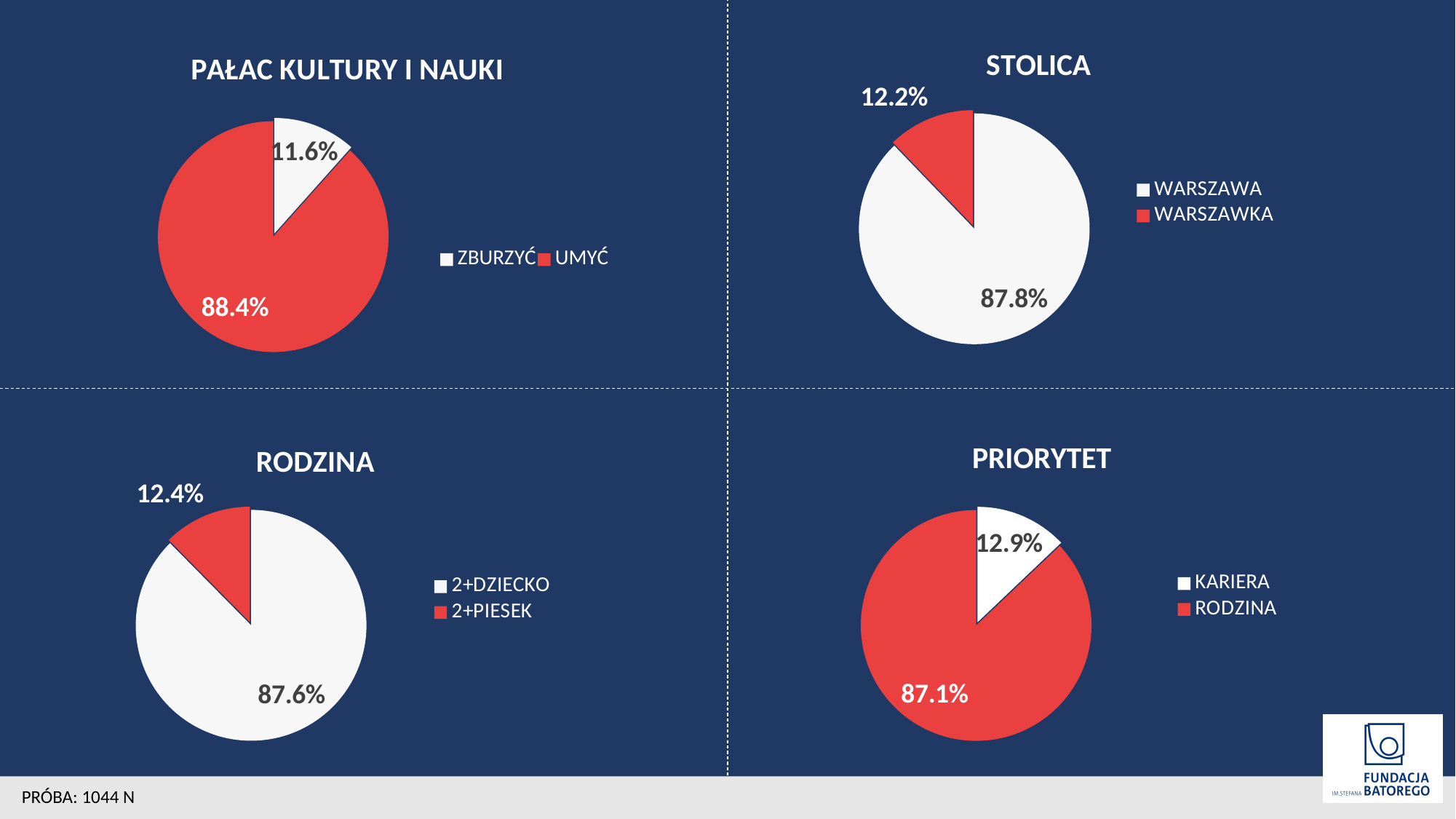
How many categories does the legend of the RODZINA chart list? 2 In the PRIORYTET chart, which is larger, KARIERA or RODZINA? RODZINA In the PAŁAC KULTURY I NAUKI chart, what share is labelled for UMYĆ? 88.4% In the STOLICA chart, what share is labelled for WARSZAWKA? 12.2% In the STOLICA chart, what colour is the WARSZAWKA slice? Red In the PRIORYTET chart, what share is labelled for KARIERA? 12.9% In the RODZINA chart, which category has the smallest slice? 2+PIESEK In the STOLICA chart, which category has the largest slice? WARSZAWA In the PAŁAC KULTURY I NAUKI chart, what share is labelled for ZBURZYĆ? 11.6% In the PRIORYTET chart, what is the difference between the RODZINA and KARIERA shares? 74.2% In the RODZINA chart, what share is labelled for 2+DZIECKO? 87.6% What kind of chart is the STOLICA chart? Pie chart